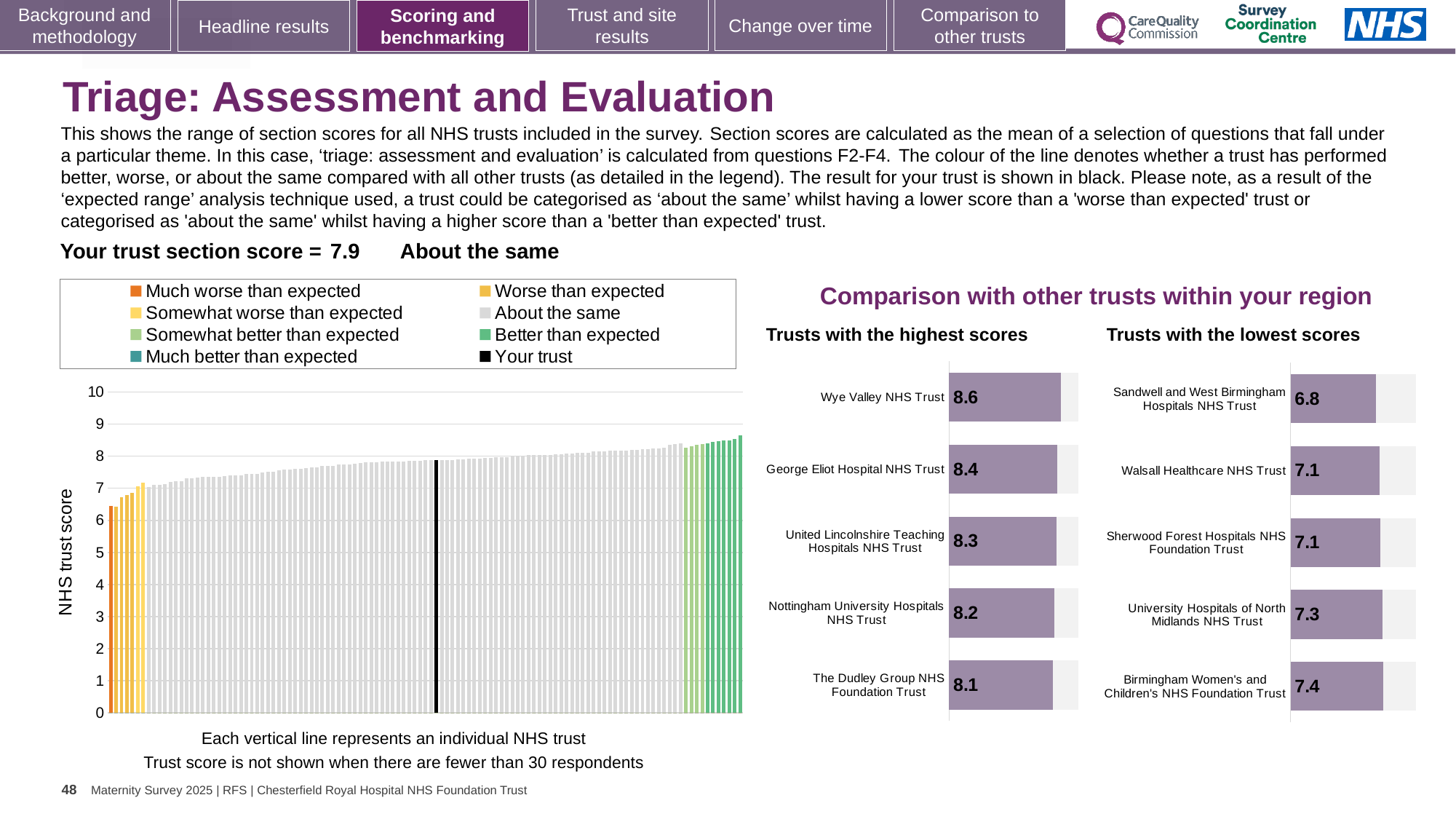
How many trusts are shown in the 'Trusts with the highest scores' chart? 5 In the main 'NHS trust score' chart, do the values rise or fall from left to right? rise In the 'Trusts with the highest scores' chart, what is the difference between the scores of Wye Valley NHS Trust and The Dudley Group NHS Foundation Trust? 0.5 In the 'Trusts with the lowest scores' chart, which trust has the lowest score? Sandwell and West Birmingham Hospitals NHS Trust In the 'Trusts with the highest scores' chart, which trust has the highest score? Wye Valley NHS Trust What is the section score for your trust, shown as the black bar in the main chart? 7.9 What kind of chart is the main 'NHS trust score' chart on the left of the slide? bar chart In the 'Trusts with the lowest scores' chart, what is the score for Sandwell and West Birmingham Hospitals NHS Trust? 6.8 In the 'Trusts with the highest scores' chart, what is the score for Wye Valley NHS Trust? 8.6 In the 'Trusts with the lowest scores' chart, which has the larger score: Walsall Healthcare NHS Trust or University Hospitals of North Midlands NHS Trust? University Hospitals of North Midlands NHS Trust What is the label on the vertical axis of the main chart on the left of the slide? NHS trust score How many entries does the legend of the main 'NHS trust score' chart list? 8